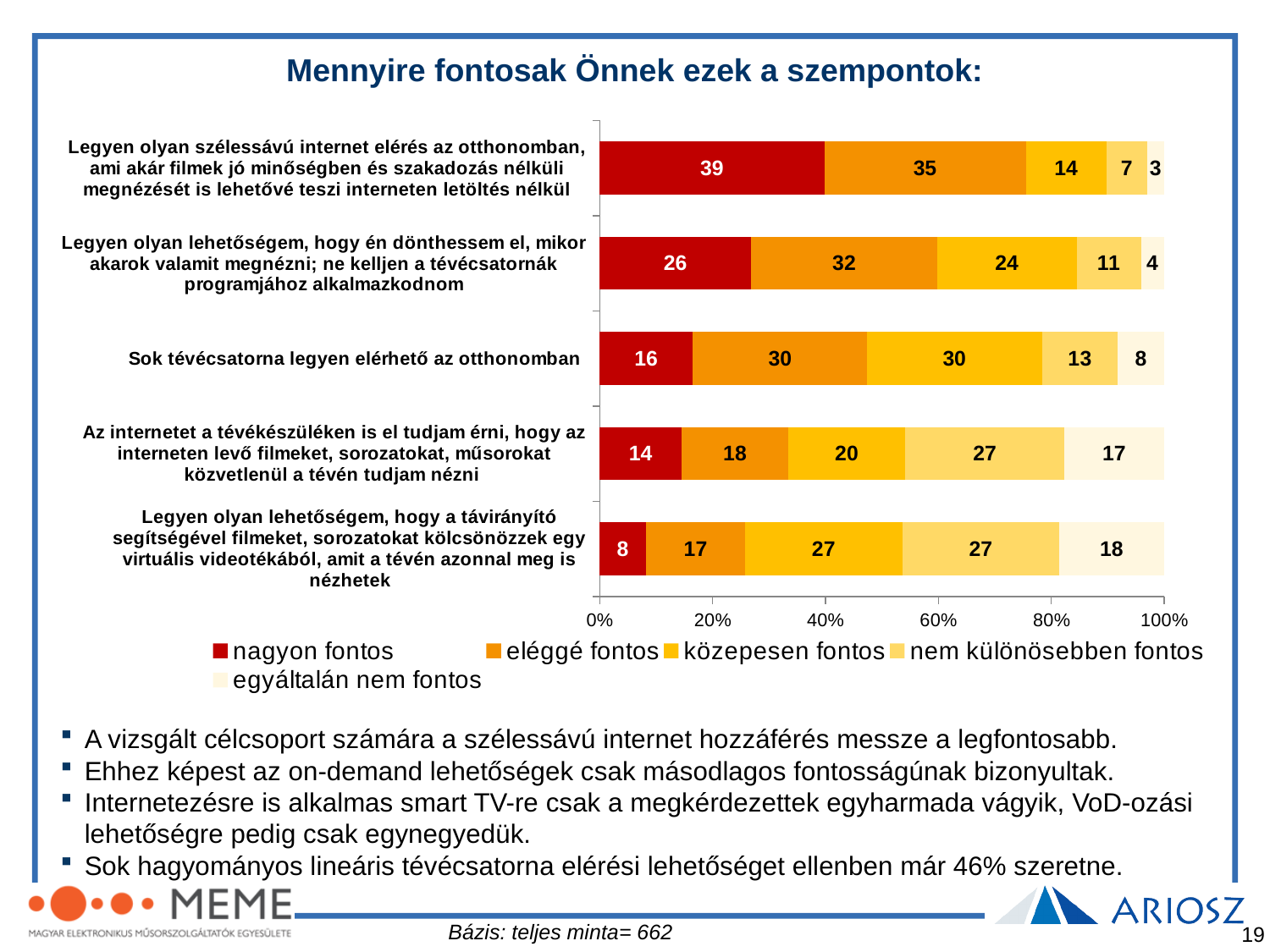
What kind of chart is shown on the slide? stacked bar chart How many series does the legend list? 5 What is the difference between the 'nagyon fontos' values for the broadband internet statement and the 'Sok tévécsatorna legyen elérhető az otthonomban' statement? 23 How many categories (statements) are plotted in the chart? 5 Which statement has the lowest 'nagyon fontos' value? Legyen olyan lehetőségem, hogy a távirányító segítségével filmeket, sorozatokat kölcsönözzek egy virtuális videotékából, amit a tévén azonnal meg is nézhetek What is the 'egyáltalán nem fontos' value for the statement about renting films from a virtual video store with the remote control? 18 What is the 'eléggé fontos' value for the statement about deciding when to watch something ('Legyen olyan lehetőségem, hogy én dönthessem el, mikor akarok valamit megnézni')? 32 What is the 'nagyon fontos' value for 'Sok tévécsatorna legyen elérhető az otthonomban'? 16 What is the combined value of 'nagyon fontos' and 'eléggé fontos' for the broadband internet statement? 74 Which is larger: the 'közepesen fontos' value for 'Sok tévécsatorna legyen elérhető az otthonomban' or for the statement about accessing the internet on the TV set? Sok tévécsatorna legyen elérhető az otthonomban Which statement has the highest 'nagyon fontos' value? Legyen olyan szélessávú internet elérés az otthonomban, ami akár filmek jó minőségben és szakadozás nélküli megnézését is lehetővé teszi interneten letöltés nélkül Which colour represents the 'nagyon fontos' series in the chart? dark red